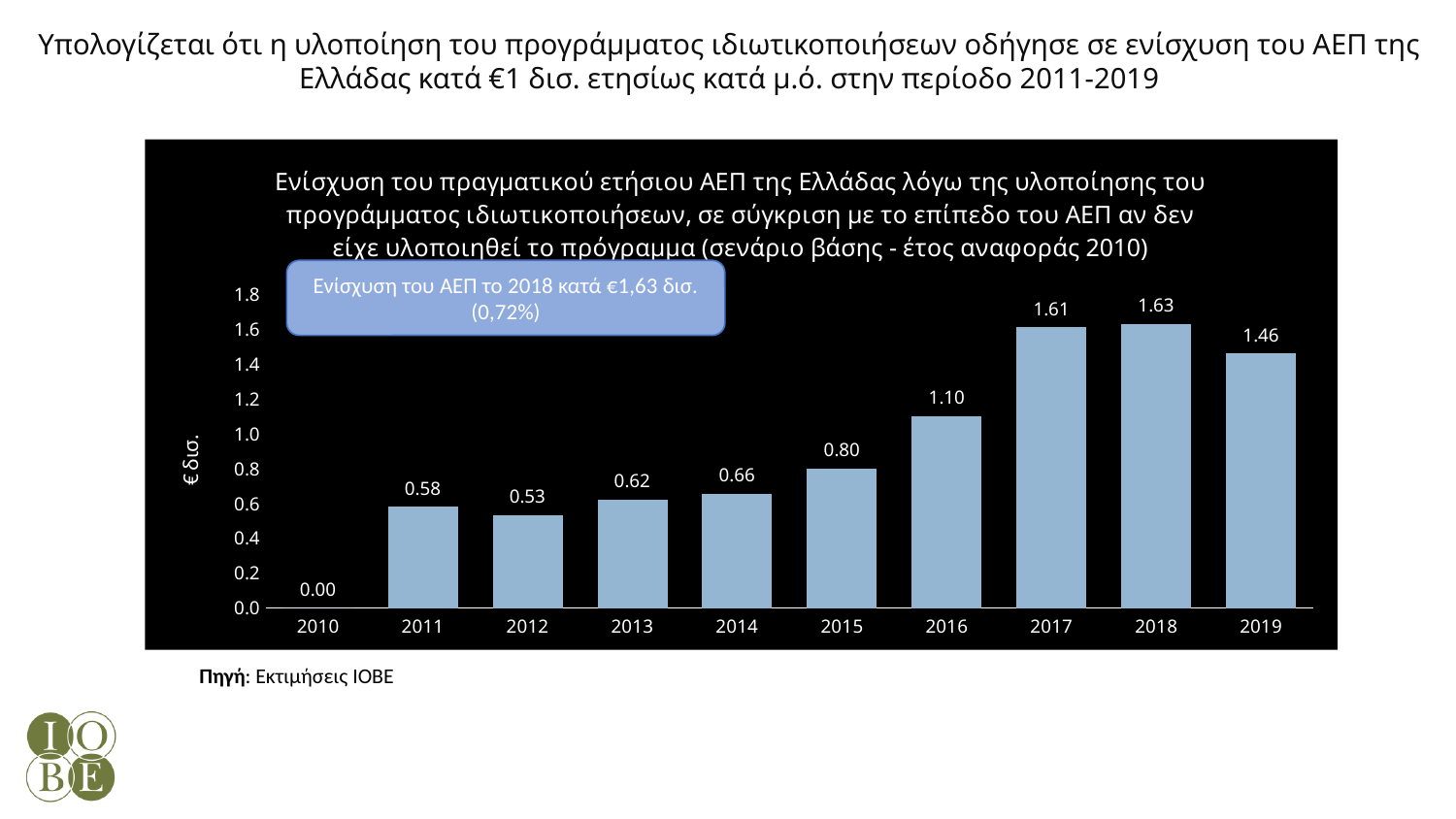
What is the value for 2015? 0.80 Do the values rise or fall from 2011 to 2018? rise What is the difference between the values for 2016 and 2015? 0.30 Which is larger, the value for 2013 or the value for 2014? 2014 How many years are shown on the x axis? 10 Which year has the lowest value? 2010 What kind of chart is this? bar chart What is the value for 2018? 1.63 What unit is shown on the y axis label? € δισ. Which year has the highest value? 2018 What is the value for 2012? 0.53 What is the difference between the values for 2018 and 2019? 0.17